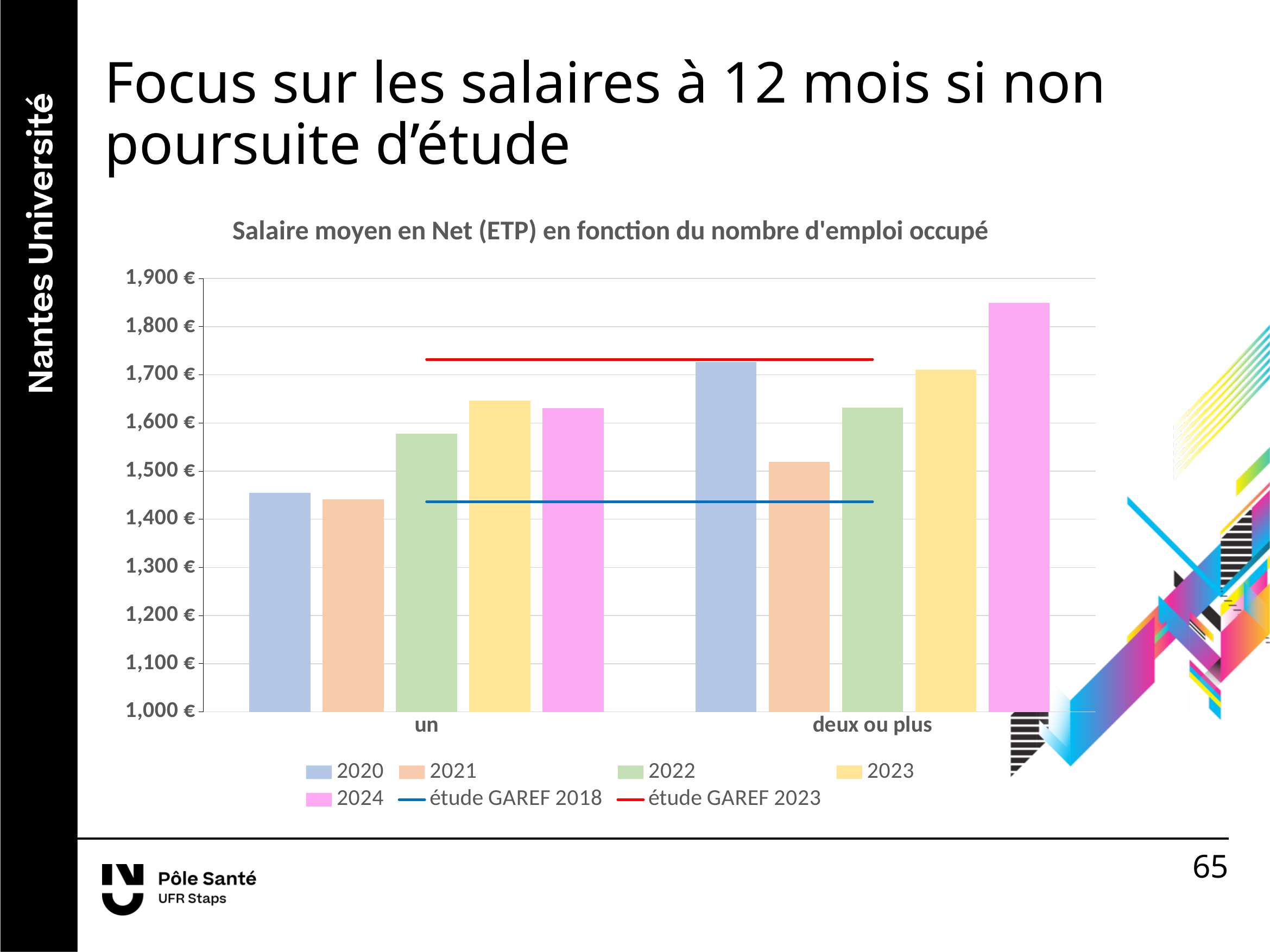
Which year has the highest bar in the 'deux ou plus' category? 2024 What colour is the line labelled 'étude GAREF 2023' in the legend? red Which is larger in the 'un' category: the 2022 bar or the 2023 bar? 2023 Is the value for 2024 in the 'deux ou plus' category greater or less than 1,800 €? greater Which year has the lowest bar in the 'deux ou plus' category? 2021 Is the value for 2020 in the 'un' category greater or less than 1,500 €? less What kind of chart is shown on the slide? combination bar and line chart What is the title of the chart? Salaire moyen en Net (ETP) en fonction du nombre d'emploi occupé Which is larger: the 2020 bar for 'un' or the 2020 bar for 'deux ou plus'? deux ou plus How many categories are shown on the x axis of the chart? 2 How many entries does the chart's legend list? 7 Is the value for 2022 in the 'deux ou plus' category greater or less than 1,600 €? greater